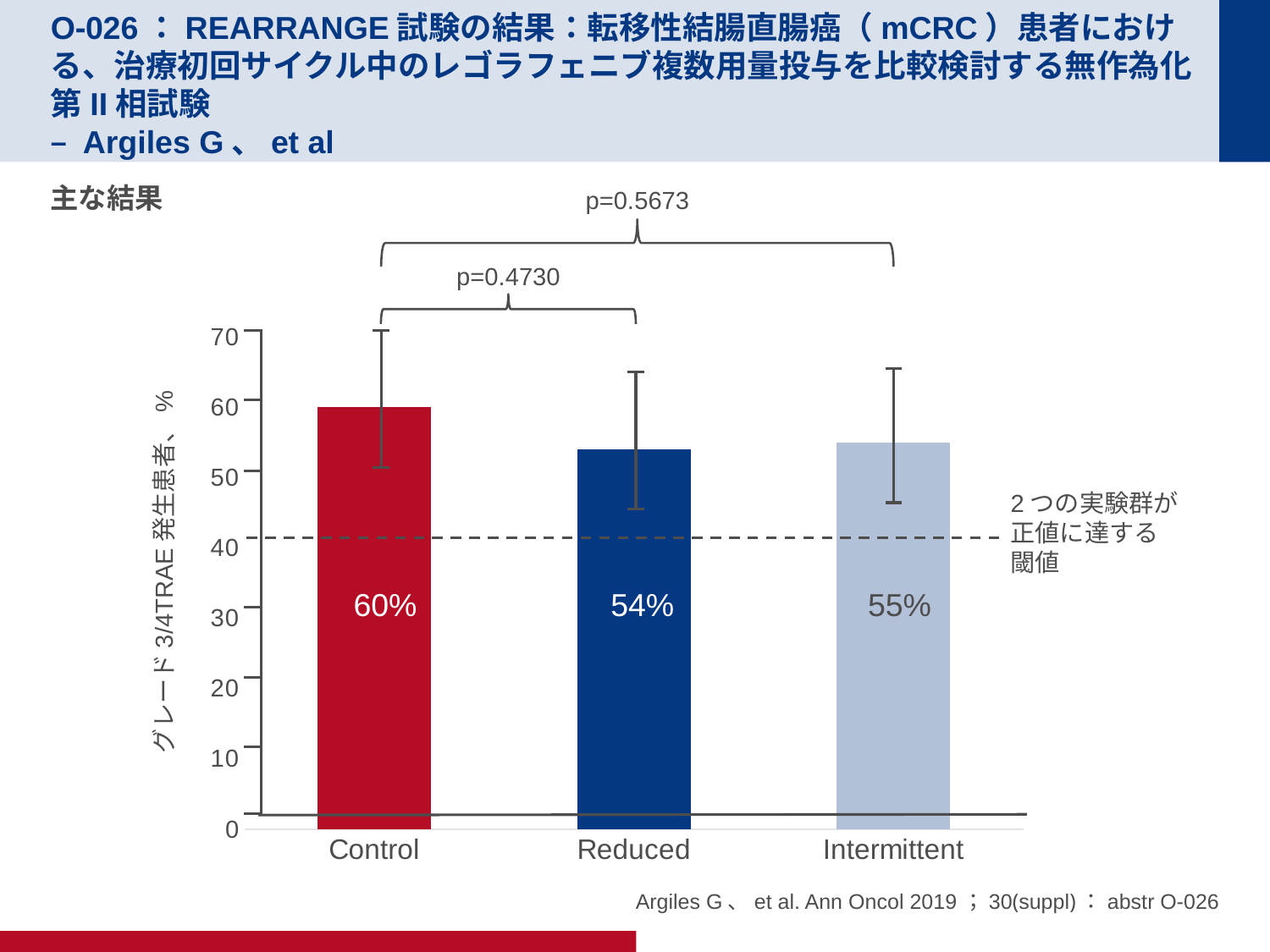
What kind of chart is shown on the slide? bar chart What is the value for the Reduced group? 54% What is the value for the Control group? 60% Is the value for Intermittent greater or less than 40? greater Which is larger, the value for Control or the value for Reduced? Control What is the value for the Intermittent group? 55% What is the difference between the Control and Intermittent values? 5 percentage points What p-value is shown for the comparison between Control and Reduced? p=0.4730 Which group has the highest percentage of patients with grade 3/4 TRAEs? Control What p-value is shown for the comparison between Control and Intermittent? p=0.5673 What is the difference between the Control and Reduced values? 6 percentage points How many groups are shown on the x axis? 3